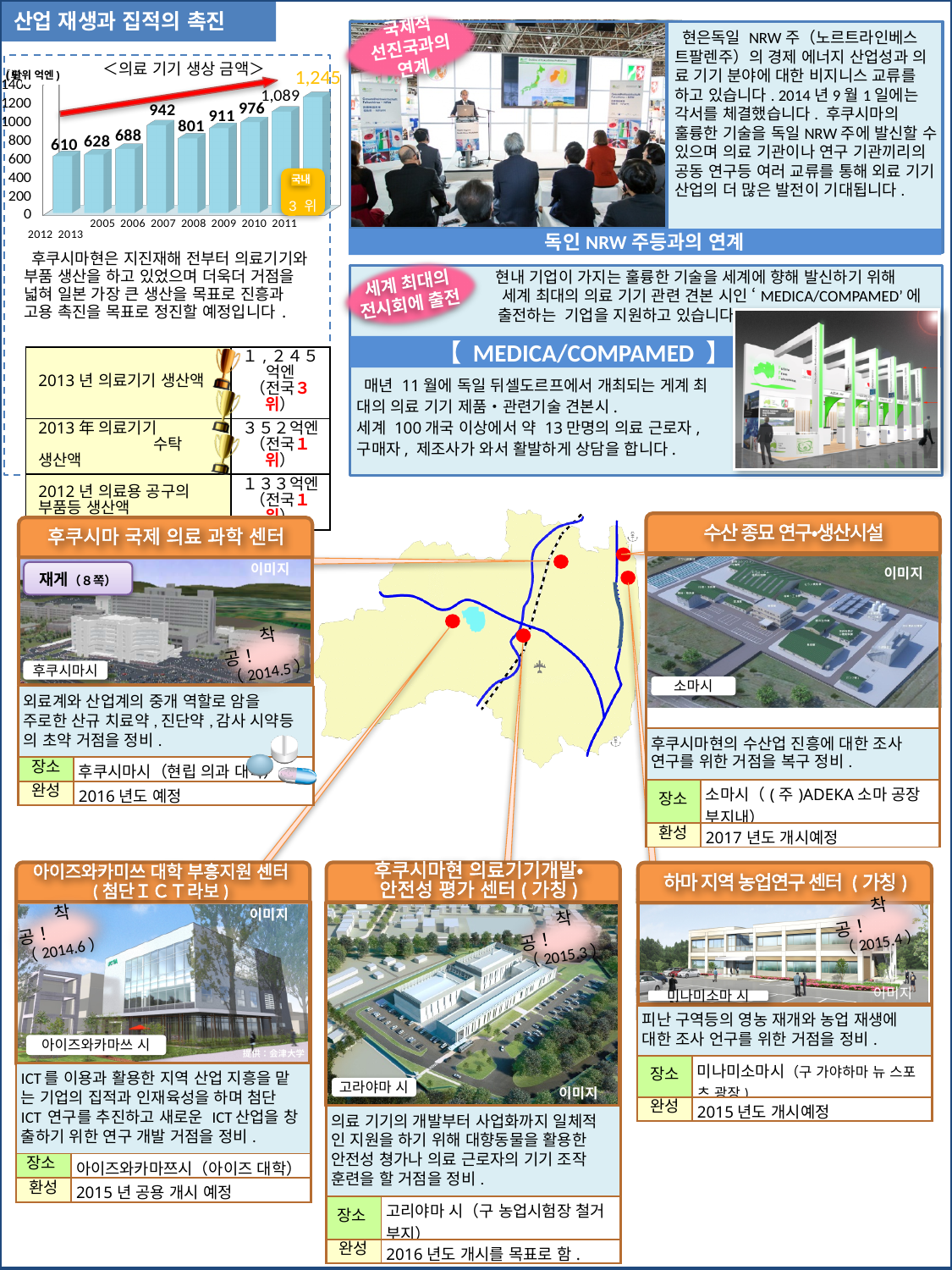
Do the bar values in the '의료 기기 생상 금액' chart generally rise or fall from left to right? rise In the '의료 기기 생상 금액' chart, what is the value labelled on the rightmost bar? 1,245 In the '의료 기기 생상 금액' chart, what is the highest value shown on a bar? 1,245 In the '의료 기기 생상 금액' chart, what is the difference between the highest bar value (1,245) and the lowest bar value (610)? 635 In the '의료 기기 생상 금액' chart, what is the value labelled on the leftmost bar? 610 What unit is shown on the vertical axis label of the '의료 기기 생상 금액' chart? 억엔 In the '의료 기기 생상 금액' chart, what is the lowest value shown on a bar? 610 What kind of chart is the '의료 기기 생상 금액' chart at the top left of the slide? bar chart How many bars are plotted in the '의료 기기 생상 금액' chart? 9 In the '의료 기기 생상 금액' chart, what is the difference between the rightmost bar (1,245) and the bar just to its left (1,089)? 156 In the '의료 기기 생상 금액' chart, is the value of the rightmost bar greater or less than 1200? greater In the '의료 기기 생상 금액' chart, is the fourth bar from the left (942) larger or smaller than the fifth bar from the left (801)? larger